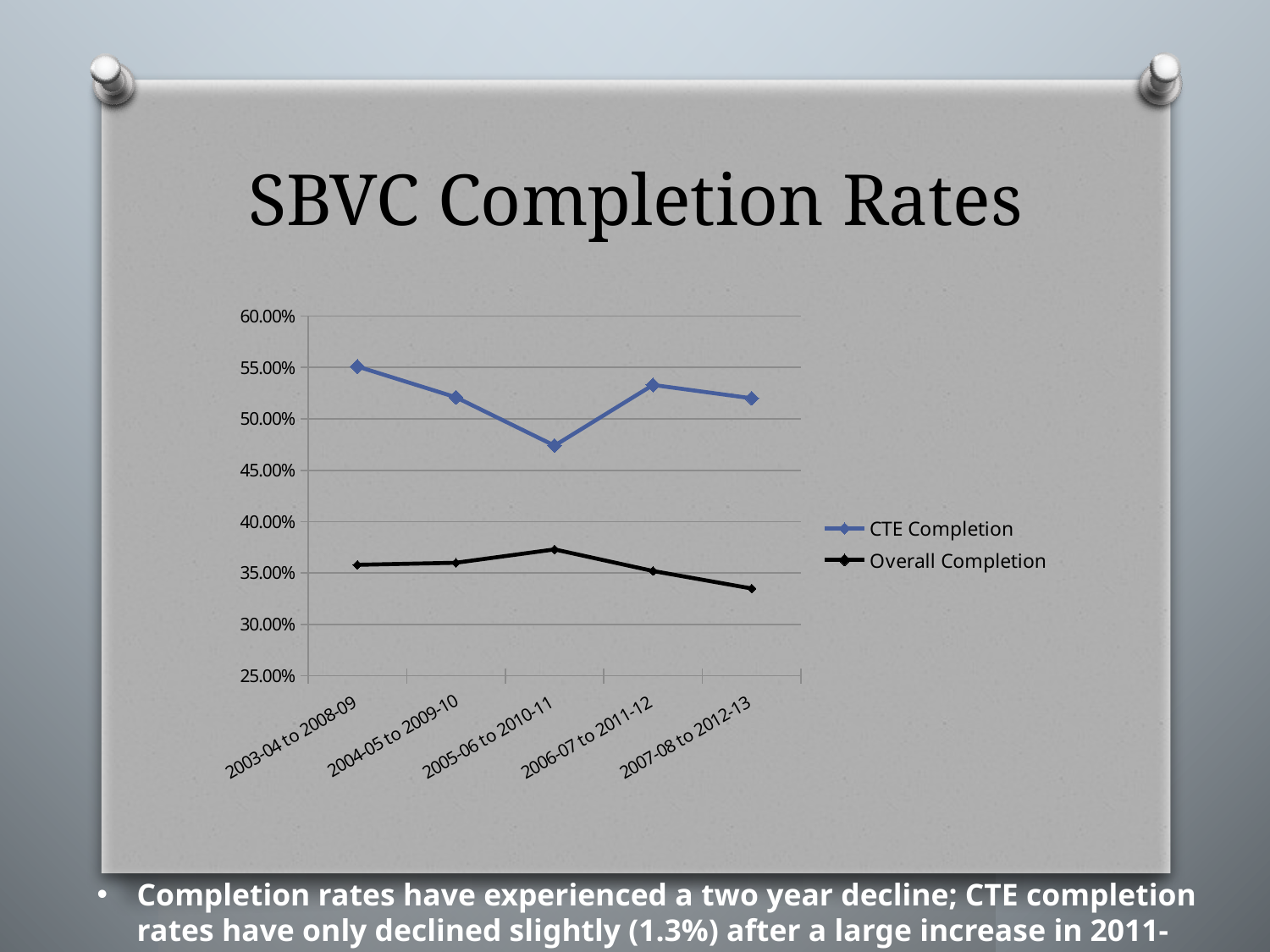
How many series does the legend list? 2 What is the title of the chart on the slide? SBVC Completion Rates In which period is Overall Completion at its highest? 2005-06 to 2010-11 Does Overall Completion rise or fall from 2005-06 to 2010-11 through 2007-08 to 2012-13? fall What kind of chart is shown on the slide? line chart Is the CTE Completion value for 2005-06 to 2010-11 greater or less than 50.00%? less In which period is CTE Completion at its lowest? 2005-06 to 2010-11 How many time periods are plotted along the x axis? 5 In which period is Overall Completion at its lowest? 2007-08 to 2012-13 In which period is CTE Completion at its highest? 2003-04 to 2008-09 Which series is higher in 2006-07 to 2011-12, CTE Completion or Overall Completion? CTE Completion Is the Overall Completion value for 2007-08 to 2012-13 greater or less than 35.00%? less